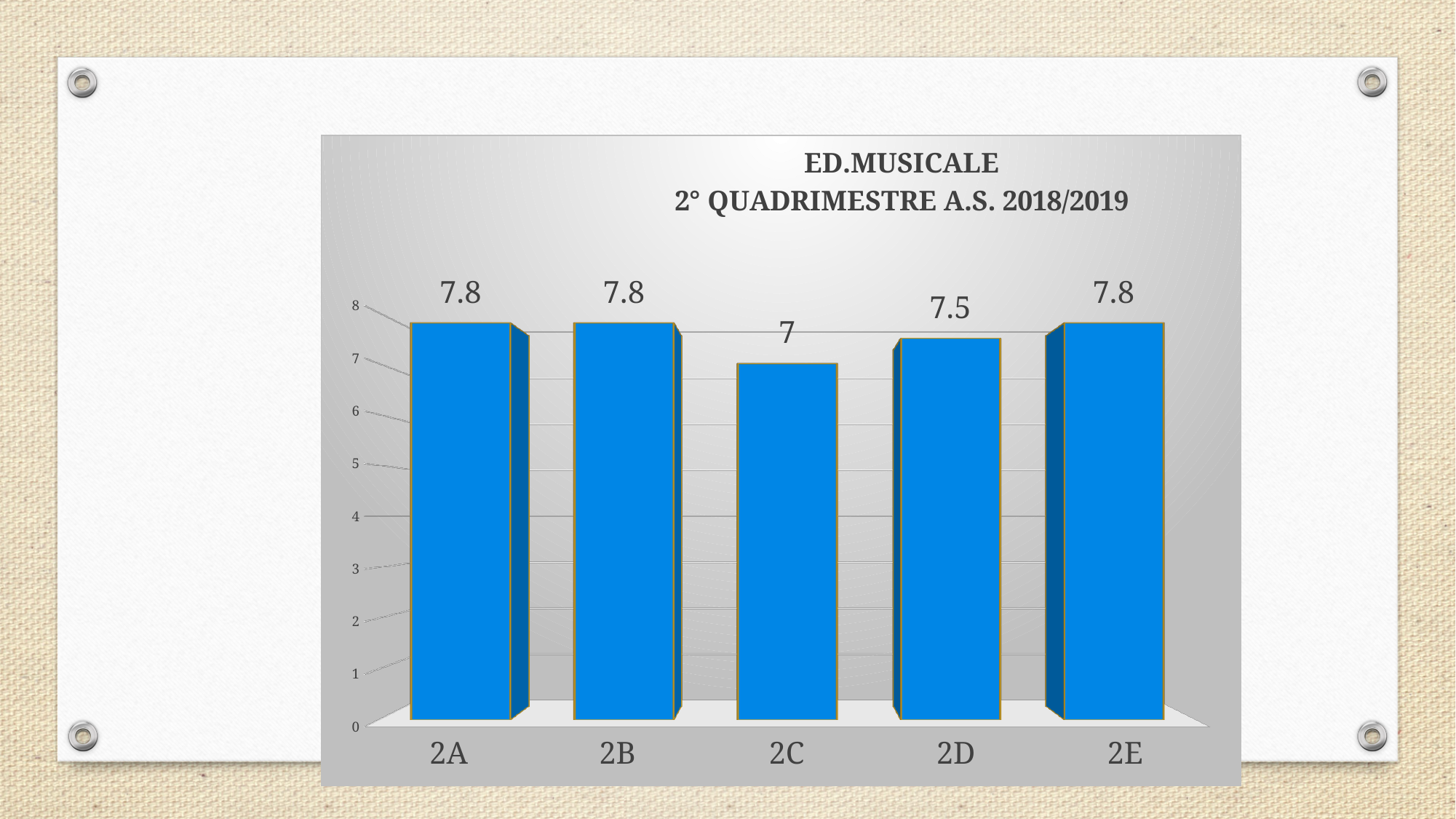
What is the value for 2E? 7.8 Which category has the lowest value? 2C Which is larger, the value for 2B or the value for 2D? 2B What is the title of the chart? ED.MUSICALE 2° QUADRIMESTRE A.S. 2018/2019 Is the value for 2C greater or less than 8? less How many categories are shown on the x axis? 5 What is the value for 2C? 7 What is the value for 2A? 7.8 What kind of chart is shown on the slide? bar chart What is the difference between the values for 2D and 2C? 0.5 What is the value for 2D? 7.5 What is the difference between the values for 2A and 2C? 0.8